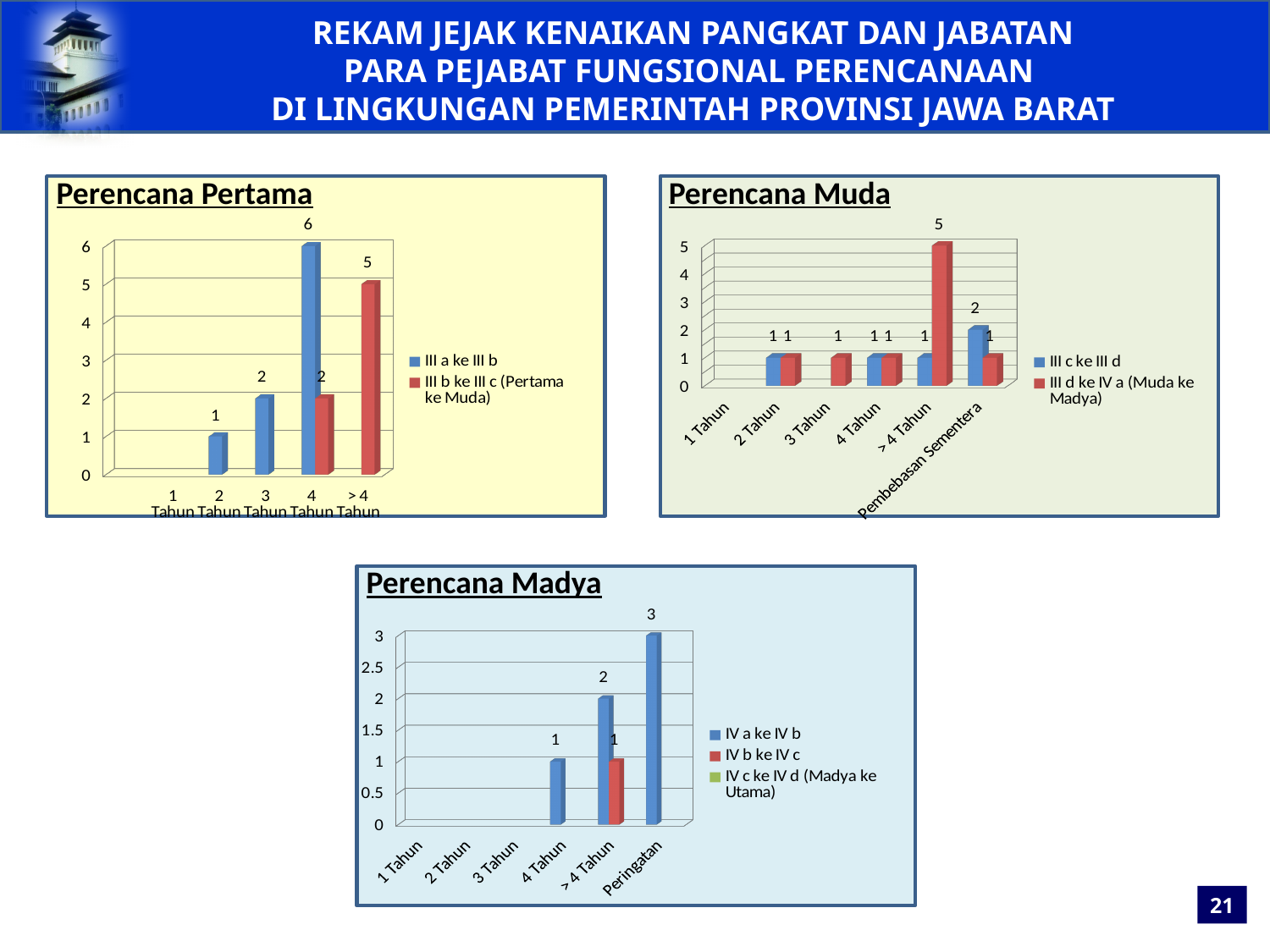
What type of chart is the Perencana Madya chart? Bar chart In the Perencana Muda chart, how many categories are shown on the x axis? 6 In the Perencana Muda chart, which category has the highest III d ke IV a (Muda ke Madya) value? > 4 Tahun In the Perencana Pertama chart, how many series does the legend list? 2 In the Perencana Madya chart, what is the value of IV a ke IV b for Peringatan? 3 In the Perencana Pertama chart, what is the value of III b ke III c (Pertama ke Muda) for > 4 Tahun? 5 In the Perencana Muda chart, what is the value of III c ke III d for Pembebasan Sementera? 2 In the Perencana Pertama chart, what is the value of III a ke III b for 4 Tahun? 6 In the Perencana Pertama chart, which category has the highest III a ke III b value? 4 Tahun In the Perencana Muda chart, what is the value of III d ke IV a (Muda ke Madya) for > 4 Tahun? 5 In the Perencana Madya chart, which is larger for > 4 Tahun: IV a ke IV b or IV b ke IV c? IV a ke IV b In the Perencana Pertama chart, what is the difference between the III a ke III b and III b ke III c values for 4 Tahun? 4